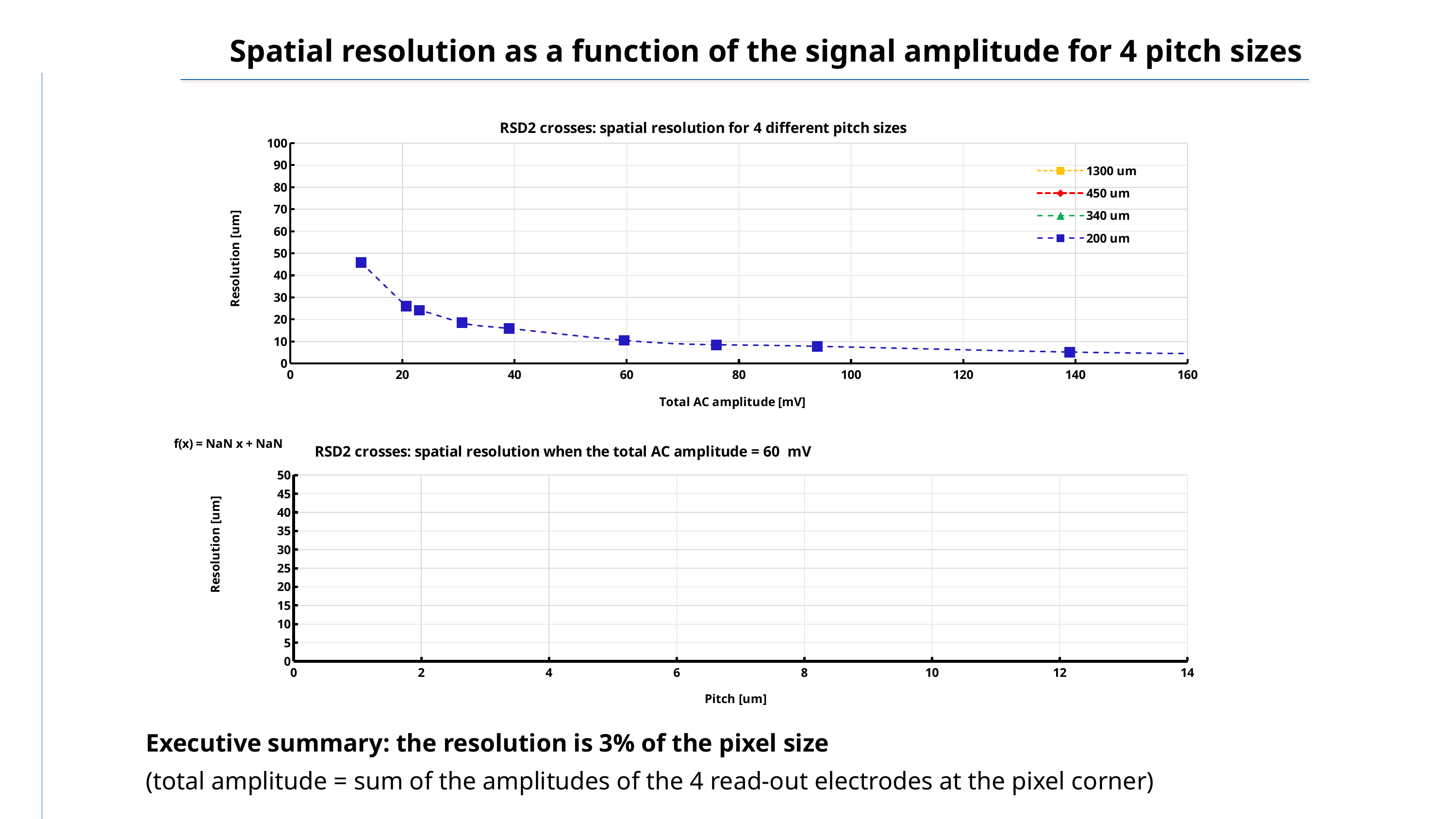
In the top chart, is the resolution of the 200 um point near 40 mV greater or less than 20 um? less In the top chart, what colour are the markers of the 200 um series? blue In the top chart, is the resolution of the 200 um point near 20 mV greater or less than 20 um? greater In the top chart, is the resolution of the leftmost 200 um point (near 12 mV) greater or less than 40 um? greater In the top chart, what is the label of the x axis? Total AC amplitude [mV] In the bottom chart, 'RSD2 crosses: spatial resolution when the total AC amplitude = 60 mV', how many data points are plotted? 0 What kind of chart is the top chart, 'RSD2 crosses: spatial resolution for 4 different pitch sizes'? line chart In the top chart, does the resolution for the 200 um series rise or fall as the total AC amplitude increases? fall In the top chart, how many series does the legend list? 4 In the top chart, how many data points are plotted for the 200 um series? 9 In the top chart, which is larger: the resolution of the 200 um point near 12 mV or the one near 94 mV? the point near 12 mV